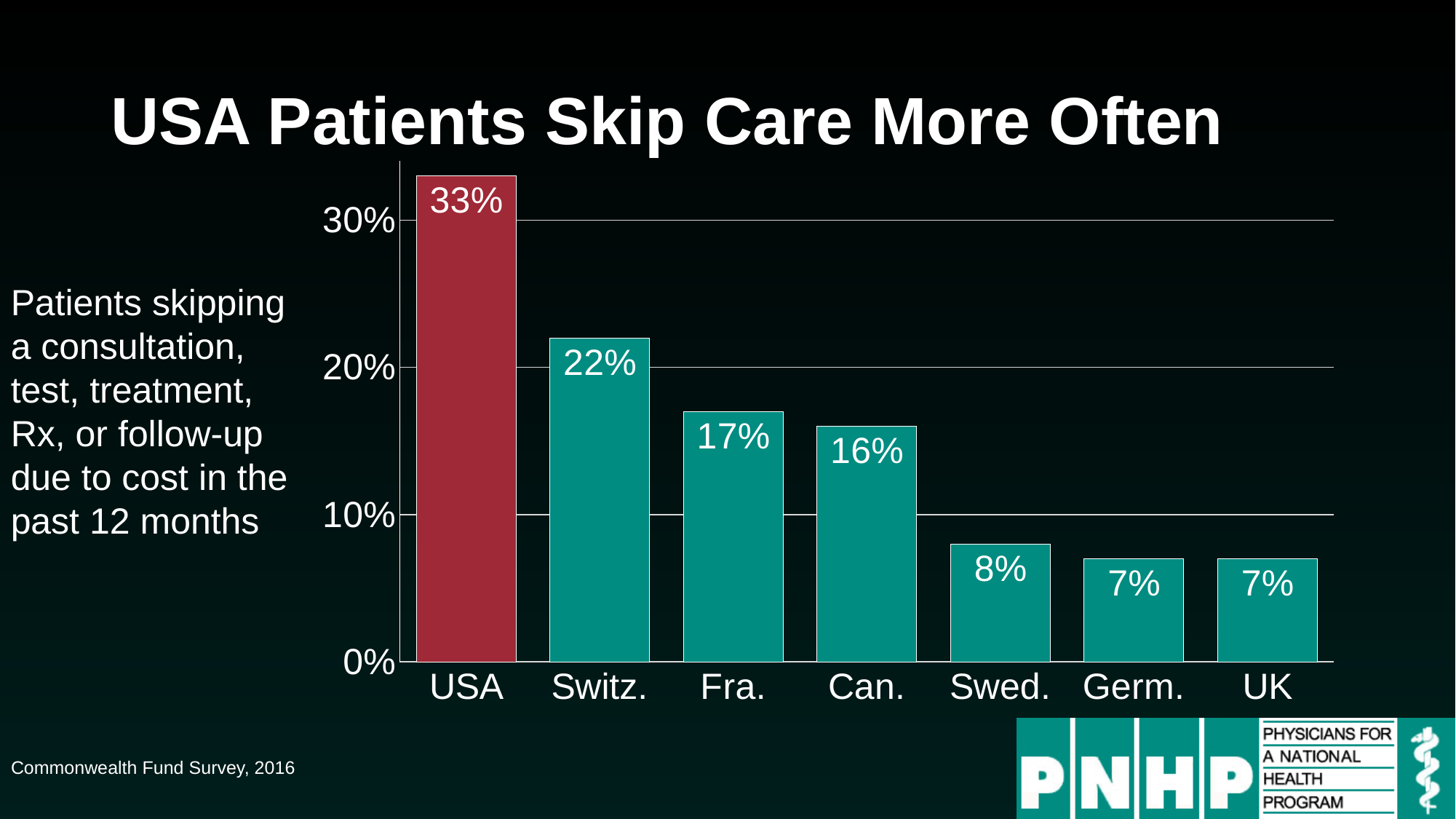
What is the difference between the Fra. value and the Swed. value? 9% What is the value shown for Switz.? 22% How many countries are shown on the chart? 7 What is the value shown for Can.? 16% Which bar is coloured differently from the others? USA Which country has the highest percentage of patients skipping care? USA Which is larger, the value for Fra. or the value for Can.? Fra. What is the difference between the USA value and the Switz. value? 11% Do the values rise or fall moving from left to right across the chart? fall What kind of chart is shown on the slide? bar chart Is the value for Swed. greater or less than 10%? less What percentage of patients in the USA skipped care due to cost? 33%